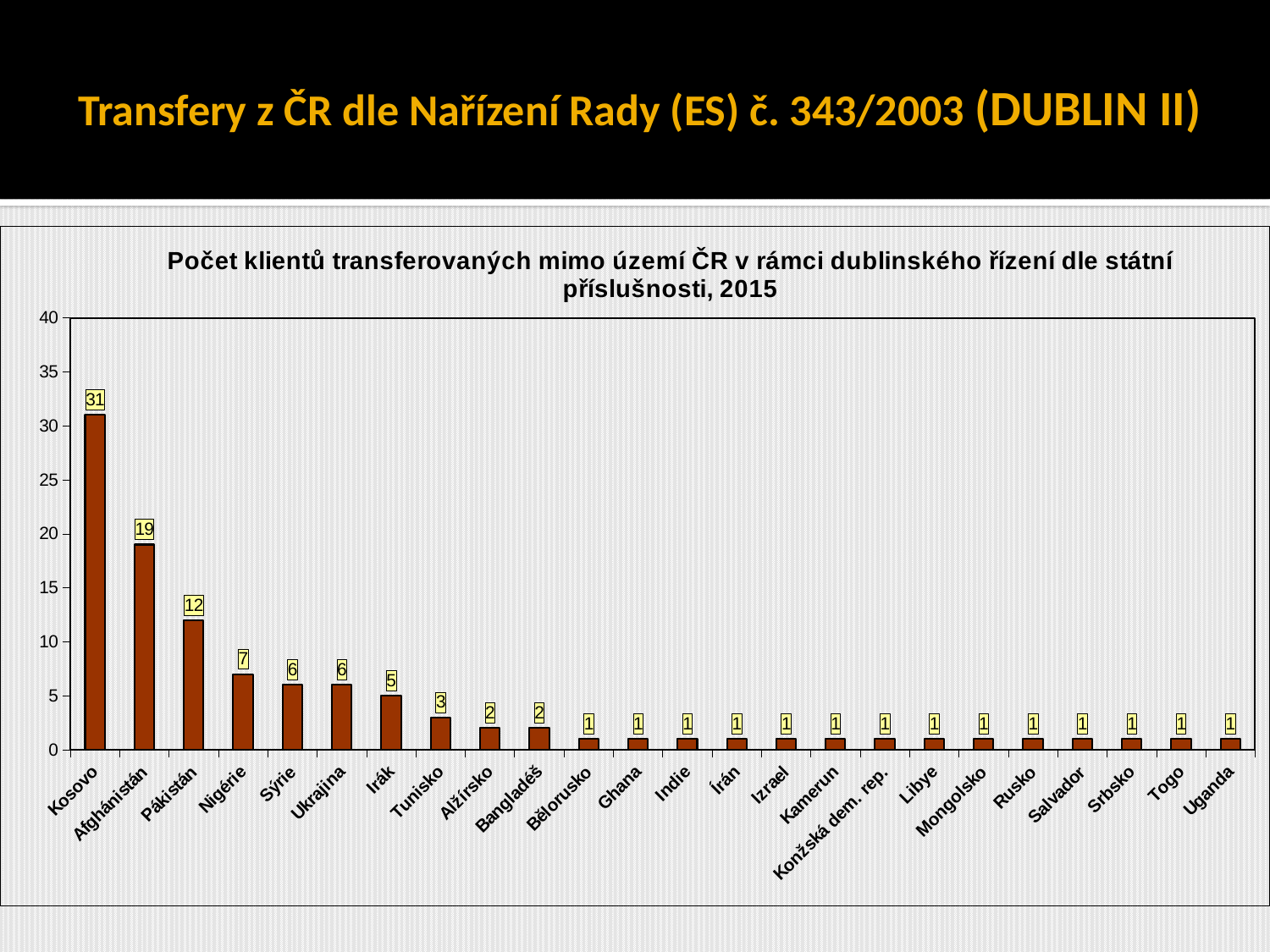
What is the difference between the values for Nigérie and Sýrie? 1 What is the value for Pákistán? 12 What is the value for Irák? 5 How many countries are shown on the x axis? 24 Which is larger, the value for Pákistán or the value for Nigérie? Pákistán Do the values rise or fall from left to right along the x axis? fall What is the value for Tunisko? 3 What kind of chart is this? bar chart What is the value for Afghánistán? 19 Which country has the highest value? Kosovo What is the value for Kosovo? 31 What is the difference between the values for Kosovo and Afghánistán? 12